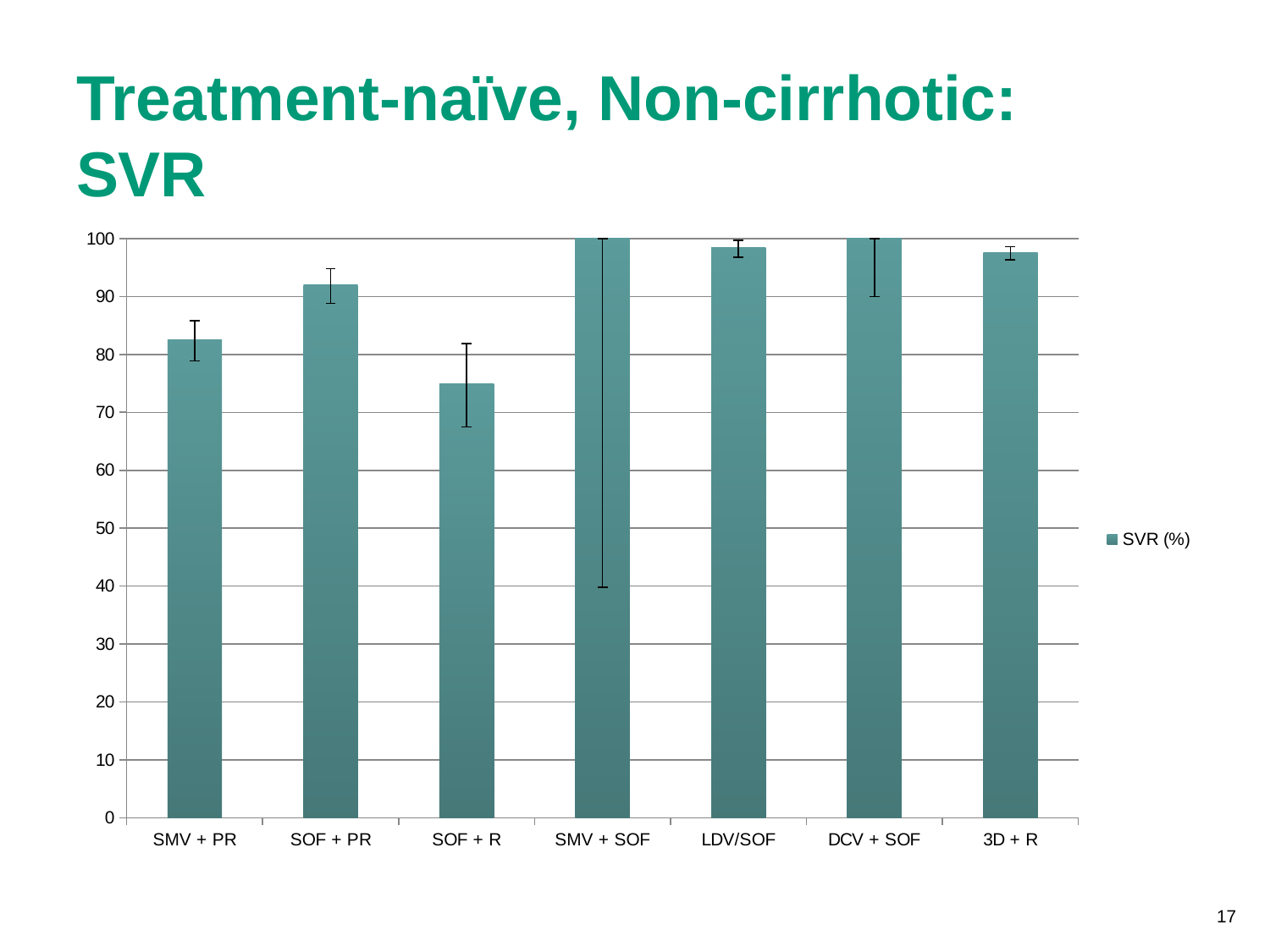
What is the SVR (%) value for SMV + SOF? 100 Which has a higher SVR (%), SMV + PR or SOF + PR? SOF + PR How many treatment regimens (categories) are shown on the x axis? 7 Which regimen has the lowest SVR (%)? SOF + R Is the SVR (%) value for SOF + R greater or less than 80? less Is the SVR (%) value for SMV + PR greater or less than 80? greater How many series does the legend list? 1 What is the title of the slide containing the chart? Treatment-naïve, Non-cirrhotic: SVR Is the SVR (%) value for 3D + R greater or less than 90? greater What is the name of the series shown in the legend? SVR (%) What kind of chart is shown on the slide? bar chart What is the SVR (%) value for DCV + SOF? 100